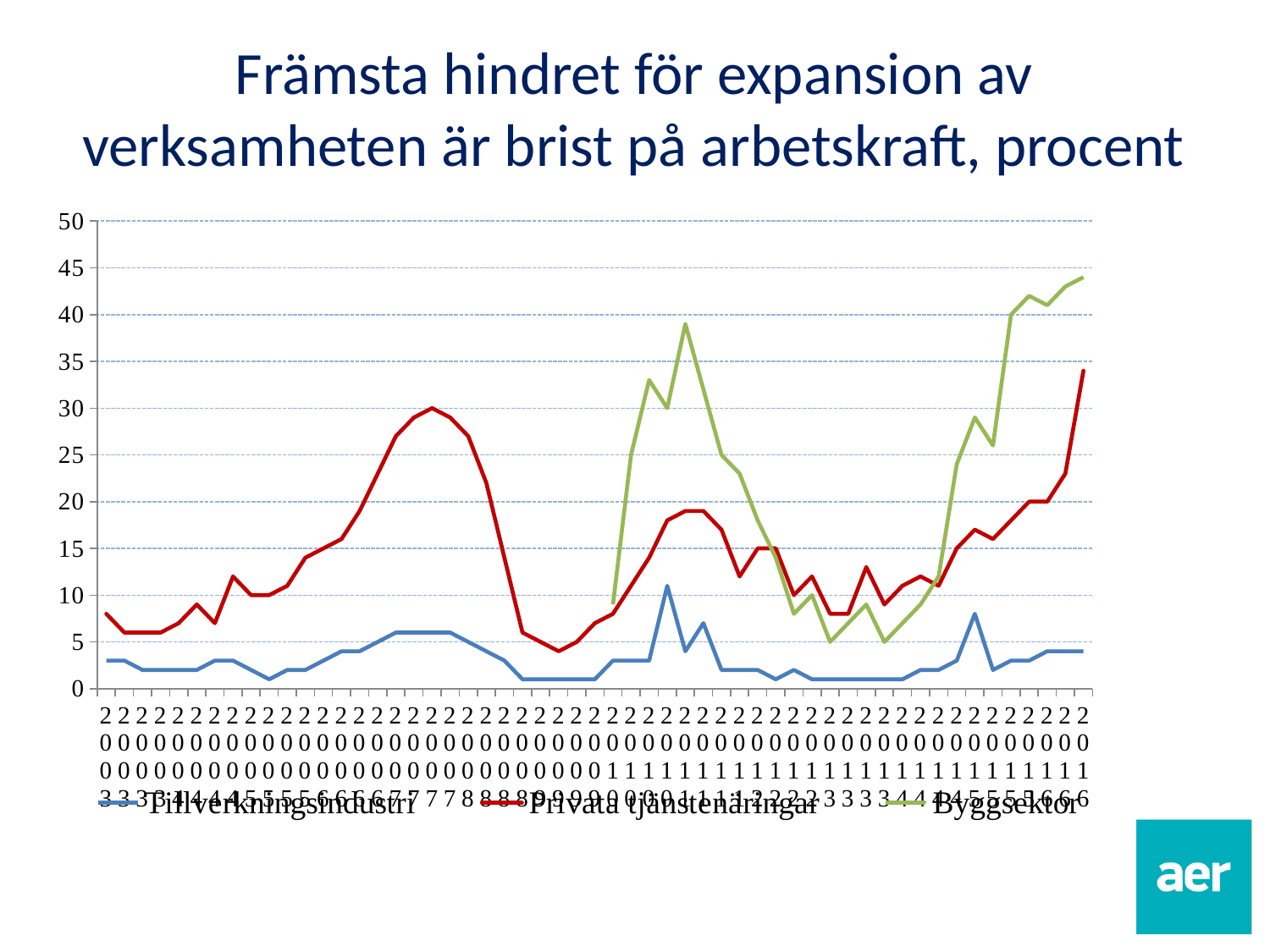
What colour is the Byggsektor line? green Over the last few points on the chart, does the Byggsektor line rise or fall? rise What is the title of the chart? Främsta hindret för expansion av verksamheten är brist på arbetskraft, procent Is the highest value reached by the Privata tjänstenäringar line greater or less than 25? greater Which series reaches the highest value anywhere on the chart? Byggsektor Is the highest value reached by the Byggsektor line greater or less than 40? greater At the right-hand end of the chart, which series is highest? Byggsektor Is the highest value reached by the Tillverkningsindustri line greater or less than 15? less How many series does the legend list? 3 What kind of chart is shown on the slide? line chart Which series has the lowest values over most of the chart? Tillverkningsindustri